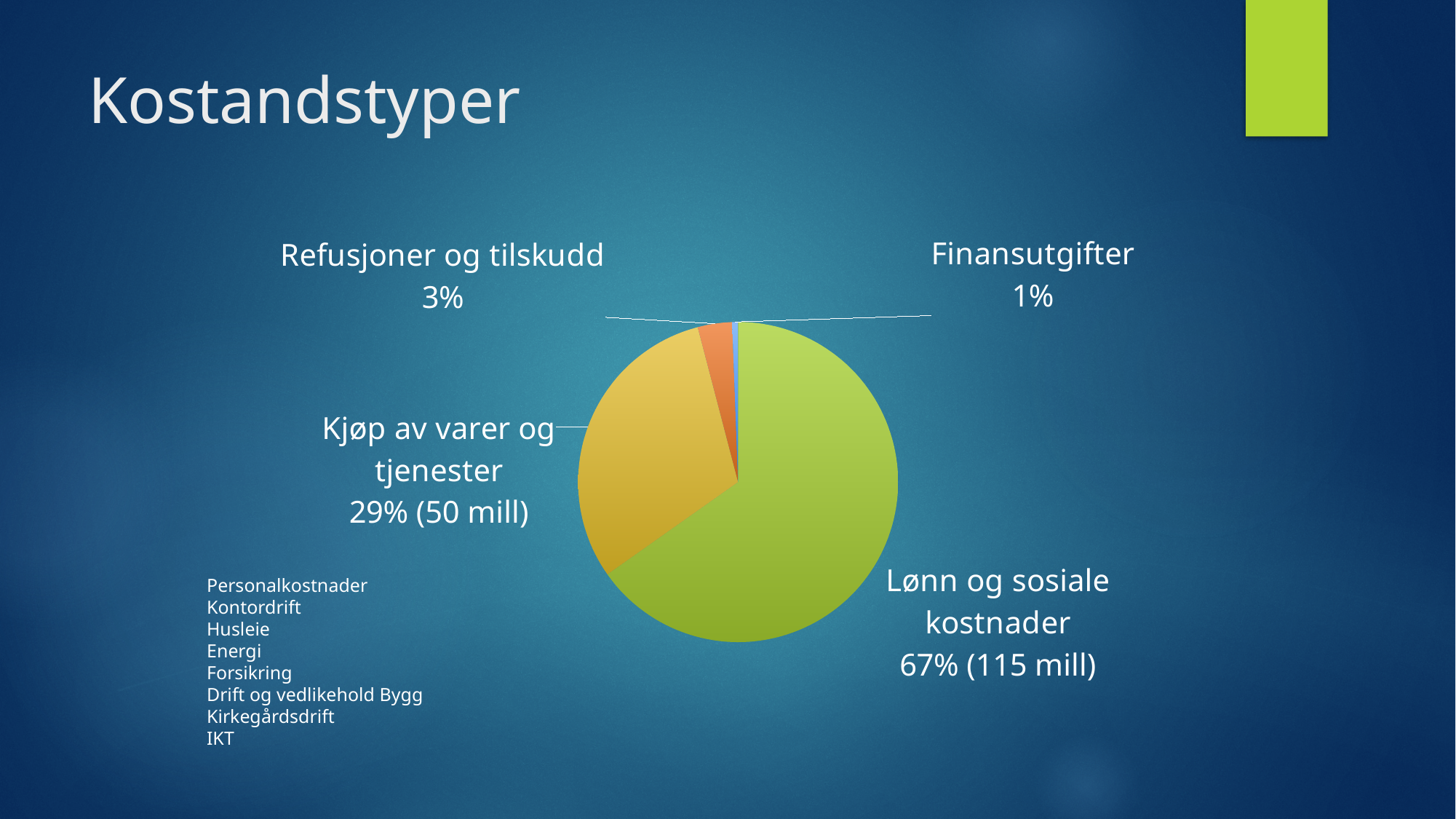
What is the difference in percentage points between Lønn og sosiale kostnader and Kjøp av varer og tjenester? 38 percentage points Which category has the smallest slice of the pie? Finansutgifter What share of the pie does Refusjoner og tilskudd represent? 3% Which category has the largest slice of the pie? Lønn og sosiale kostnader What is the title of the slide containing the pie chart? Kostandstyper How many slices does the pie chart have? 4 What share of the pie does Kjøp av varer og tjenester represent? 29% What amount in millions is shown for Kjøp av varer og tjenester? 50 mill What amount in millions is shown for Lønn og sosiale kostnader? 115 mill What kind of chart is shown on the slide? pie chart What share of the pie does Finansutgifter represent? 1%